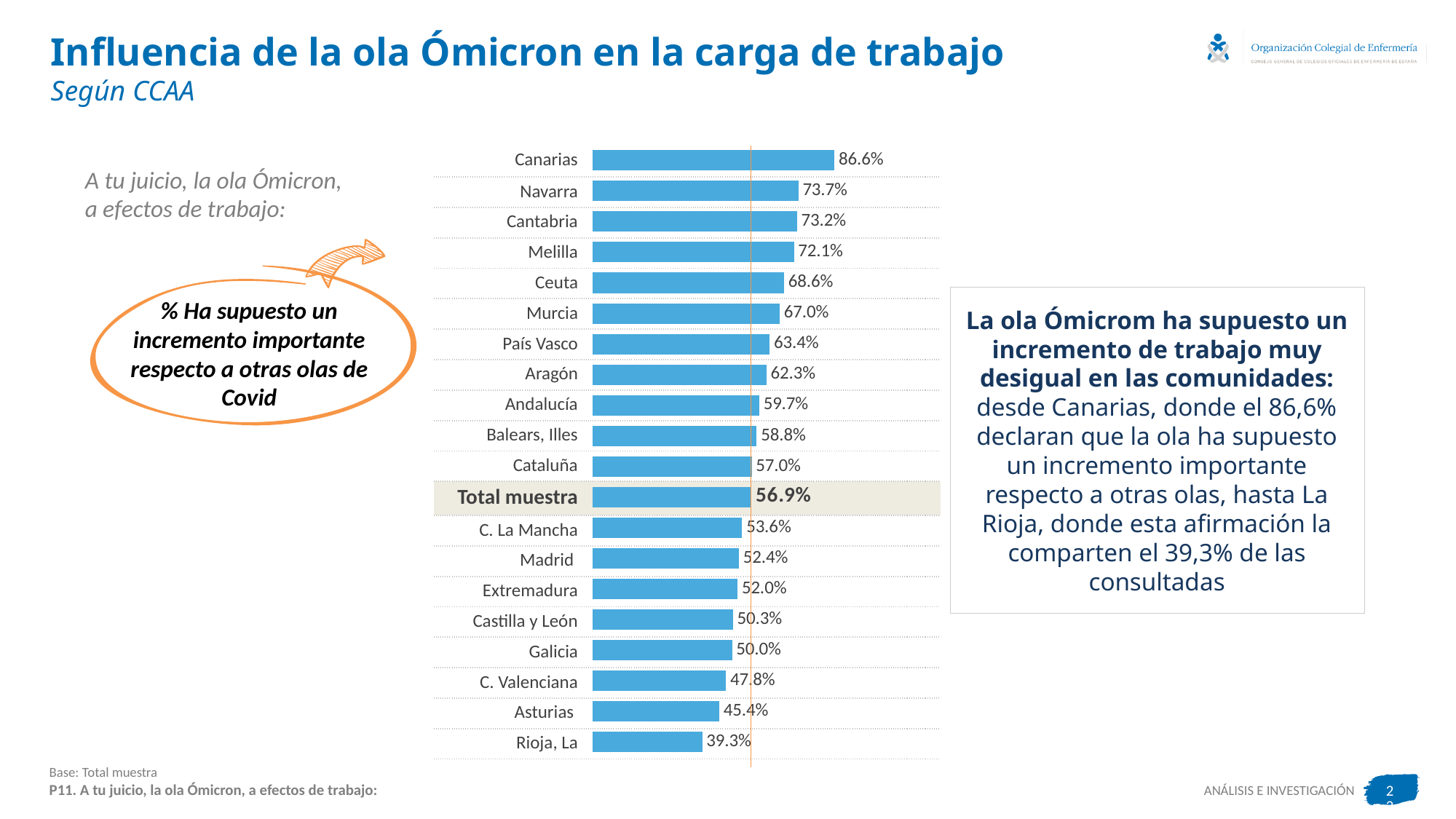
Which has a larger value, Murcia or Madrid? Murcia What is the value shown for Canarias? 86.6% Which category has the lowest value in the chart? Rioja, La What is the difference in percentage points between Navarra and Cantabria? 0.5 percentage points What is the difference in percentage points between Canarias and Rioja, La? 47.3 percentage points Which category has the highest value in the chart? Canarias What kind of chart is shown on the slide? Bar chart What is the value shown for Asturias? 45.4% What is the value shown for Galicia? 50.0% Do the values rise or fall going from the top bar to the bottom bar? Fall What is the value shown for Total muestra? 56.9% How many bars are plotted in the chart, including Total muestra? 20